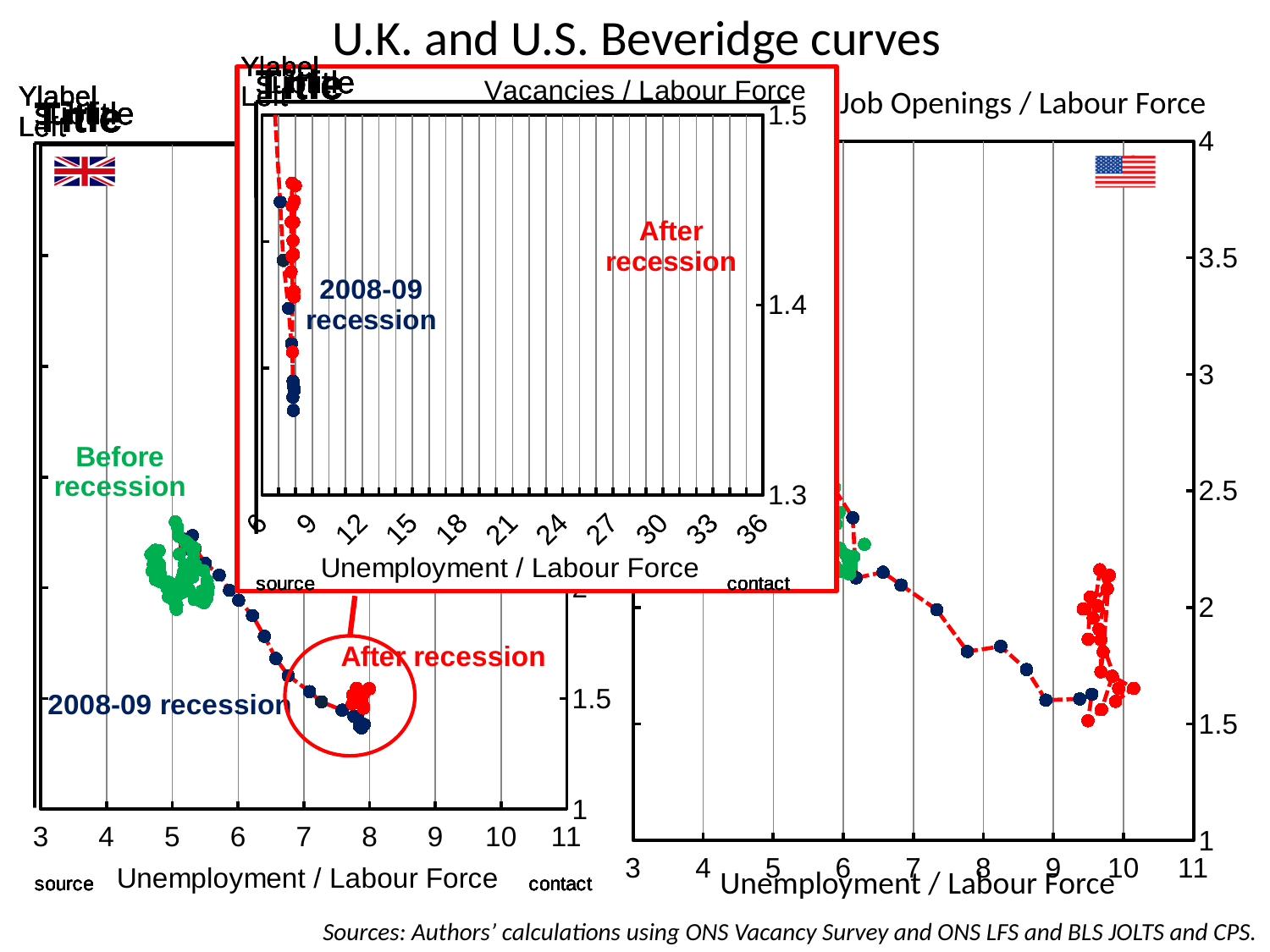
What is the title of the slide? U.K. and U.S. Beveridge curves How many charts are shown on the slide? 3 What is the y-axis label of the right (U.S.) chart? Job Openings / Labour Force In the right (U.S.) chart, is the job openings value for the red cluster greater or less than 2.5? less In the left (U.K.) chart, is the unemployment value for the 'Before recession' cluster greater or less than 6? less In the right (U.S.) chart, is the unemployment value for the red 'after recession' cluster greater or less than 9? greater In the left (U.K.) chart, do vacancies rise or fall as unemployment increases along the curve? fall What is the highest tick shown on the y-axis of the right (U.S.) chart? 4 In the left (U.K.) chart, which cluster has higher unemployment, 'Before recession' or 'After recession'? After recession What kind of chart is the left (U.K.) chart? scatter chart